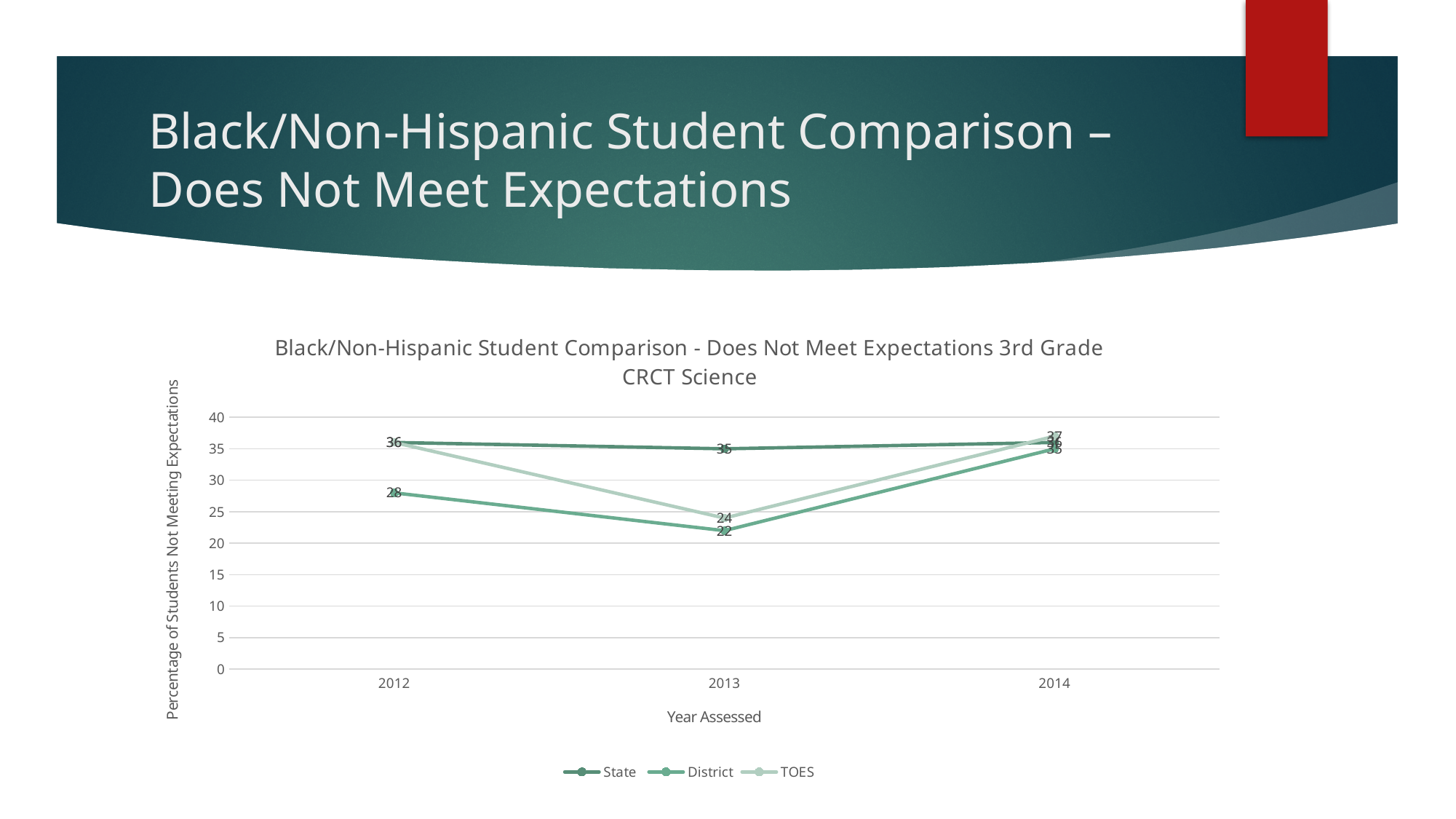
What kind of chart is shown on the slide? line chart In which year is the District value lowest? 2013 How many series does the legend list? 3 What is the State value for 2013? 35 Is the District value for 2014 greater or less than 30? greater What is the difference between the District values for 2012 and 2013? 6 How many years are plotted on the x axis? 3 Which is larger in 2013, the State value or the District value? State What is the District value for 2013? 22 What is the District value for 2012? 28 What is the TOES value for 2013? 24 What is the State value for 2012? 36